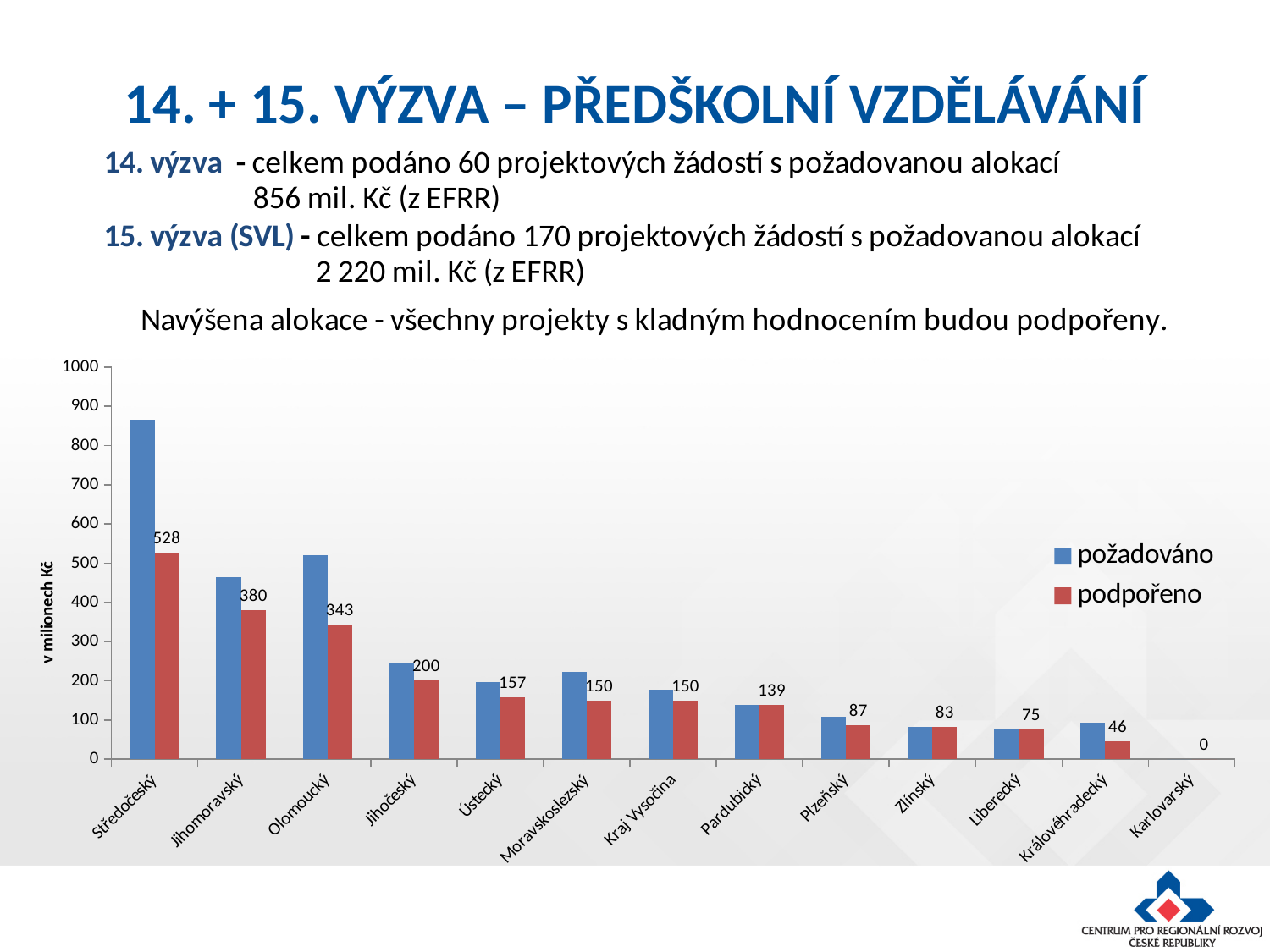
What kind of chart is shown on the slide? bar chart Which region has the highest podpořeno value? Středočeský Which has the larger podpořeno value, Plzeňský or Zlínský? Plzeňský What is the podpořeno value for Středočeský? 528 Is the požadováno value for Středočeský greater or less than 800? greater What is the podpořeno value for Královéhradecký? 46 How many regions are shown on the x axis? 13 Is the požadováno value for Olomoucký greater or less than 500? greater How many series does the legend list? 2 What is the difference between the podpořeno values for Jihomoravský and Olomoucký? 37 Which region has the lowest podpořeno value? Karlovarský What is the podpořeno value for Jihočeský? 200